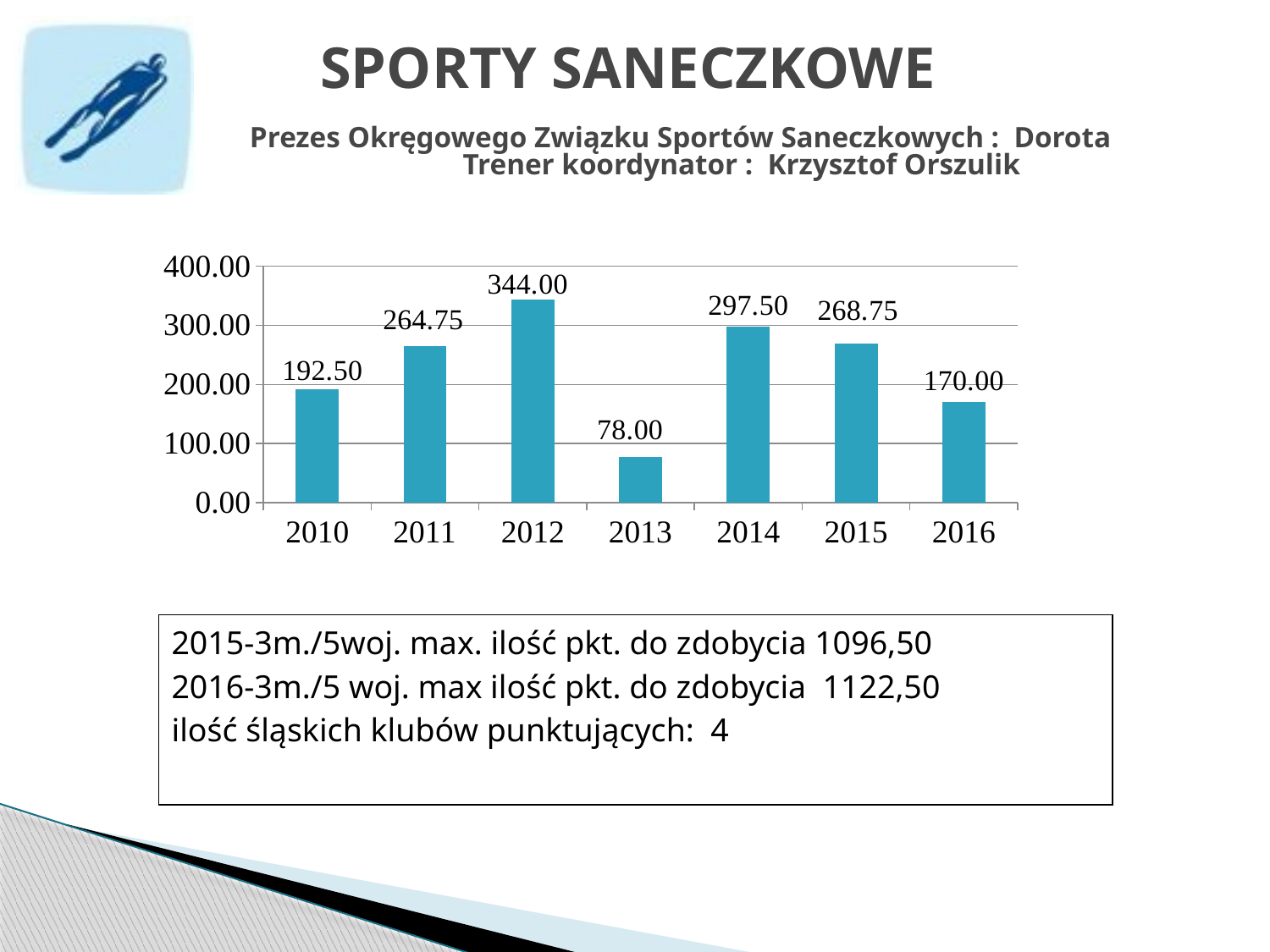
What is the difference between the values for 2012 and 2013? 266.00 Which year has the lowest value? 2013 Which is larger, the value for 2011 or the value for 2015? 2015 Is the value for 2010 greater or less than 200.00? less How many years are shown on the x axis? 7 Do the values rise or fall from 2014 to 2016? fall Which year has the highest value? 2012 What is the value for 2016? 170.00 What is the value for 2013? 78.00 What kind of chart is shown on the slide? bar chart What is the difference between the values for 2014 and 2015? 28.75 What is the value for 2012? 344.00